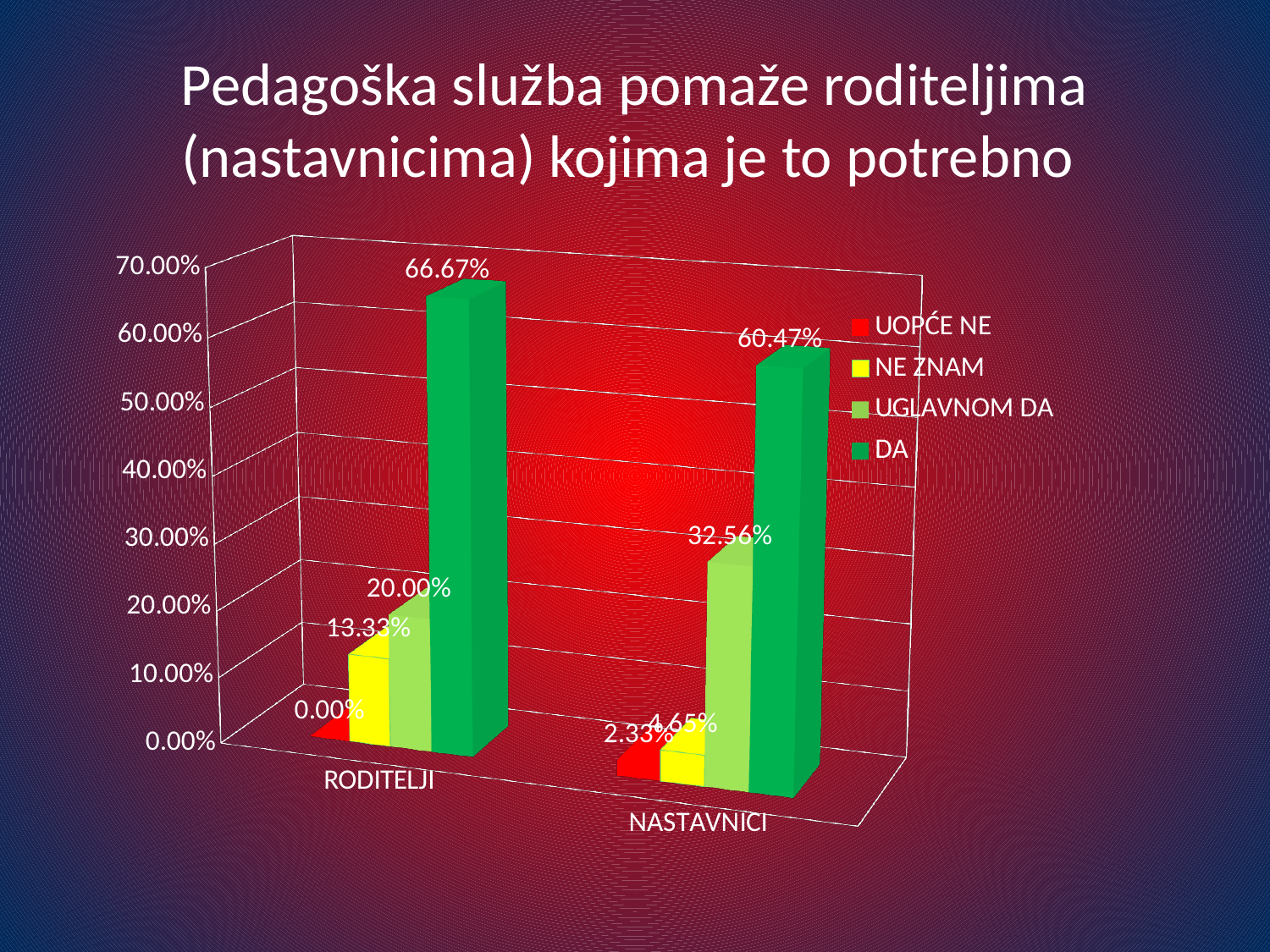
Which series has the lowest value in the NASTAVNICI category? UOPĆE NE How many categories are shown on the x axis? 2 Which category has the larger value for DA, RODITELJI or NASTAVNICI? RODITELJI What is the value for DA in the NASTAVNICI category? 60.47% Which series has the highest value in the RODITELJI category? DA What is the value for NE ZNAM in the RODITELJI category? 13.33% What is the value for UOPĆE NE in the NASTAVNICI category? 2.33% What is the value for UGLAVNOM DA in the NASTAVNICI category? 32.56% What is the value for DA in the RODITELJI category? 66.67% What is the difference between the UGLAVNOM DA values for NASTAVNICI and RODITELJI? 12.56% What kind of chart is shown on the slide? Bar chart How many series does the legend list? 4